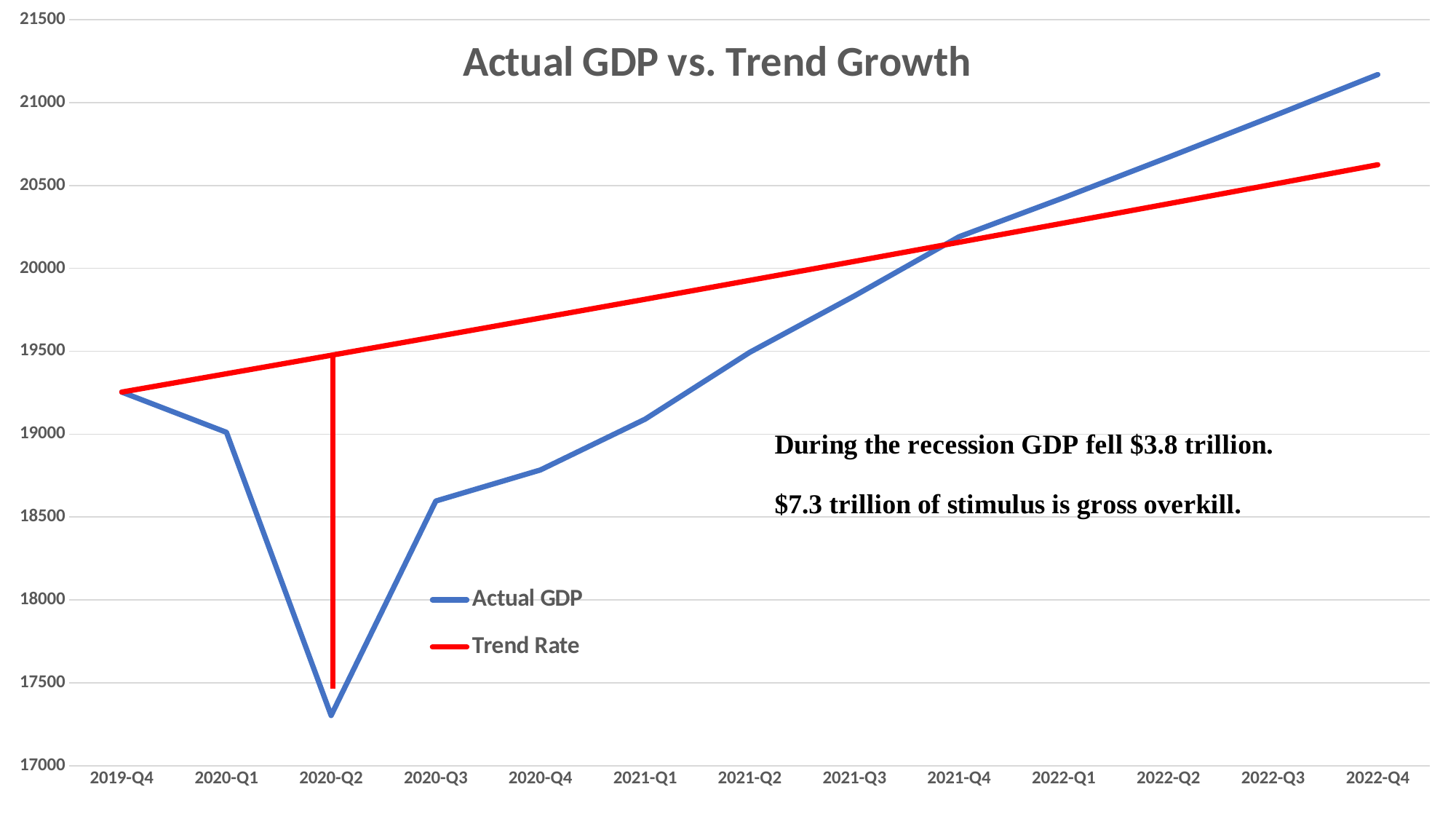
What kind of chart is shown on the slide? line chart How many quarters are plotted along the x axis? 13 In which quarter is Actual GDP at its lowest? 2020-Q2 In which quarter is Actual GDP at its highest? 2022-Q4 What is the title of the chart? Actual GDP vs. Trend Growth In 2020-Q2, which series has the larger value, Actual GDP or Trend Rate? Trend Rate How many series does the legend list? 2 Is the value of Trend Rate in 2019-Q4 greater or less than 19500? less In 2022-Q4, which series has the larger value, Actual GDP or Trend Rate? Actual GDP Is the value of Actual GDP in 2020-Q2 greater or less than 17500? less Is the value of Actual GDP in 2022-Q4 greater or less than 21000? greater